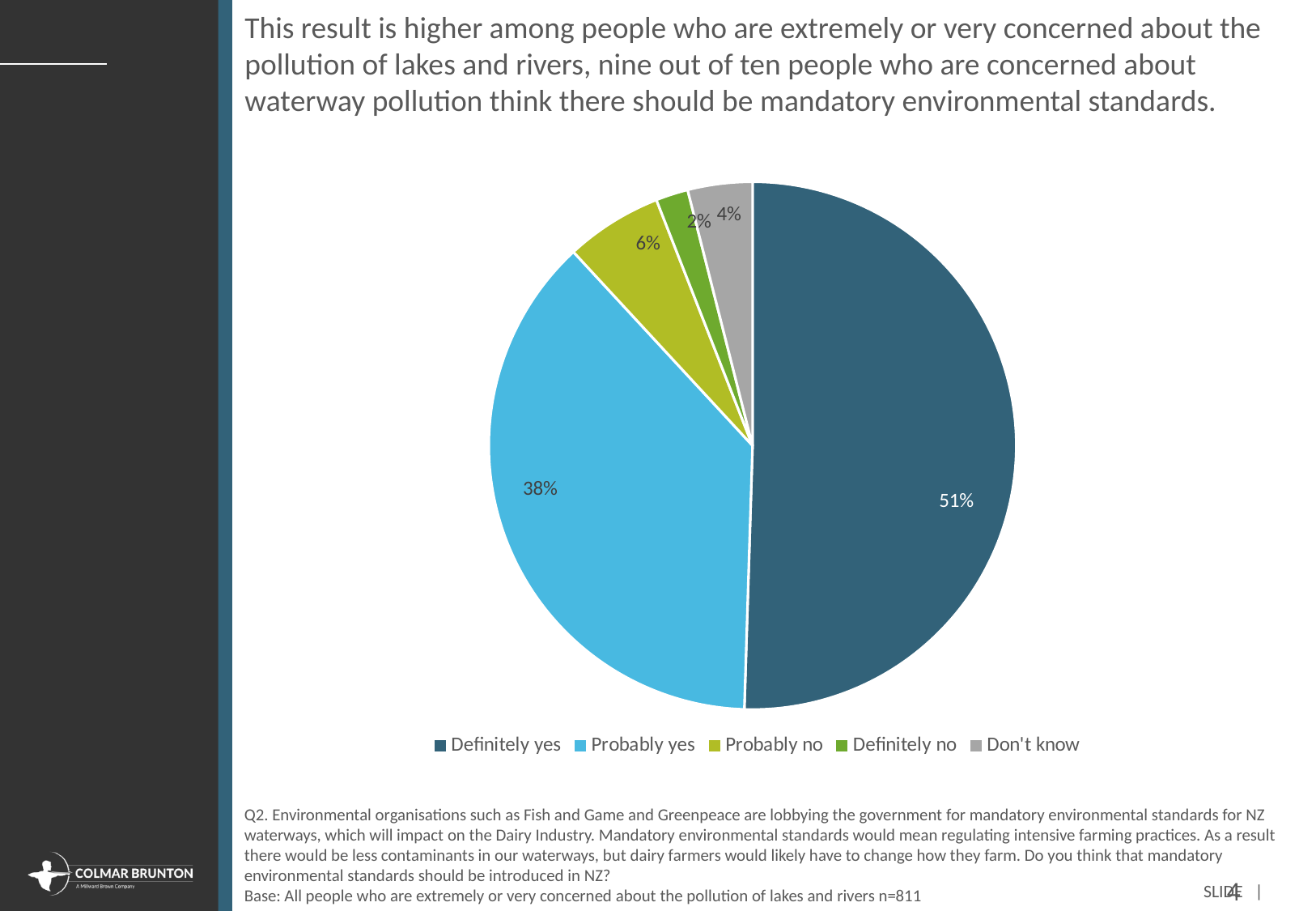
What percentage of respondents answered "Definitely yes"? 51% How many entries does the legend list? 5 What kind of chart is shown on the slide? pie chart What percentage of respondents answered "Probably no"? 6% What percentage of respondents answered "Probably yes"? 38% Which is larger, the share for "Probably no" or the share for "Don't know"? Probably no Which response has the largest share of the pie? Definitely yes How many slices does the pie chart have? 5 What colour is the "Probably yes" slice? light blue What is the difference in percentage points between "Definitely yes" and "Probably yes"? 13 Which response has the smallest share of the pie? Definitely no What percentage of respondents answered "Don't know"? 4%